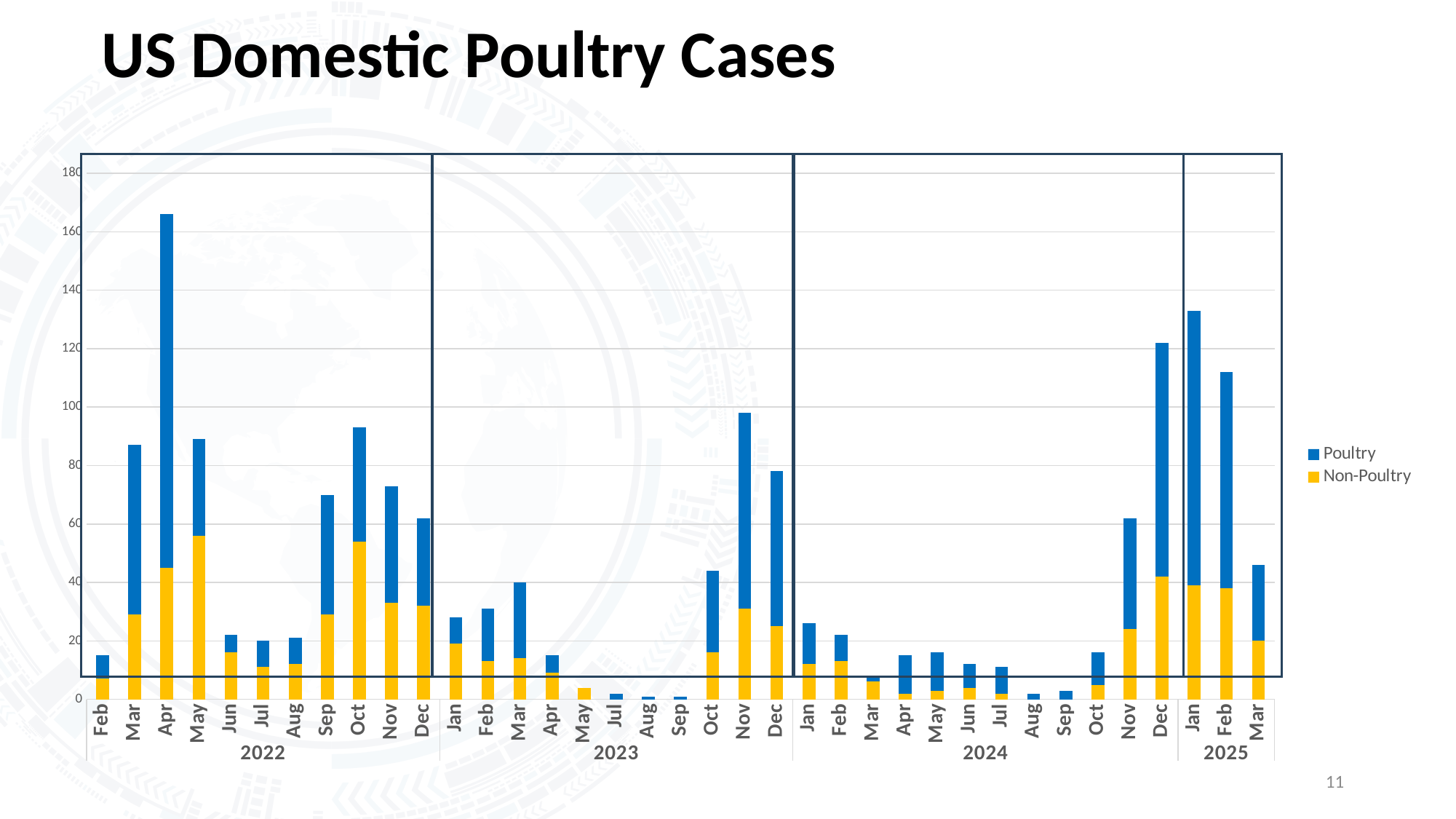
Is the total value for Apr 2022 greater or less than 140? greater How many series does the legend list? 2 What are the two series named in the legend? Poultry and Non-Poultry Is the total value for Jan 2025 greater or less than 120? greater Is the total value for Dec 2024 greater or less than 100? greater Which has the larger total bar, Feb 2025 or Dec 2024? Dec 2024 Which colour represents Non-Poultry in the chart? yellow What kind of chart is shown on the slide? stacked bar chart Which month has the highest total bar in the chart? Apr 2022 Which has the larger total bar, Jan 2025 or Dec 2024? Jan 2025 How many months are plotted for 2025? 3